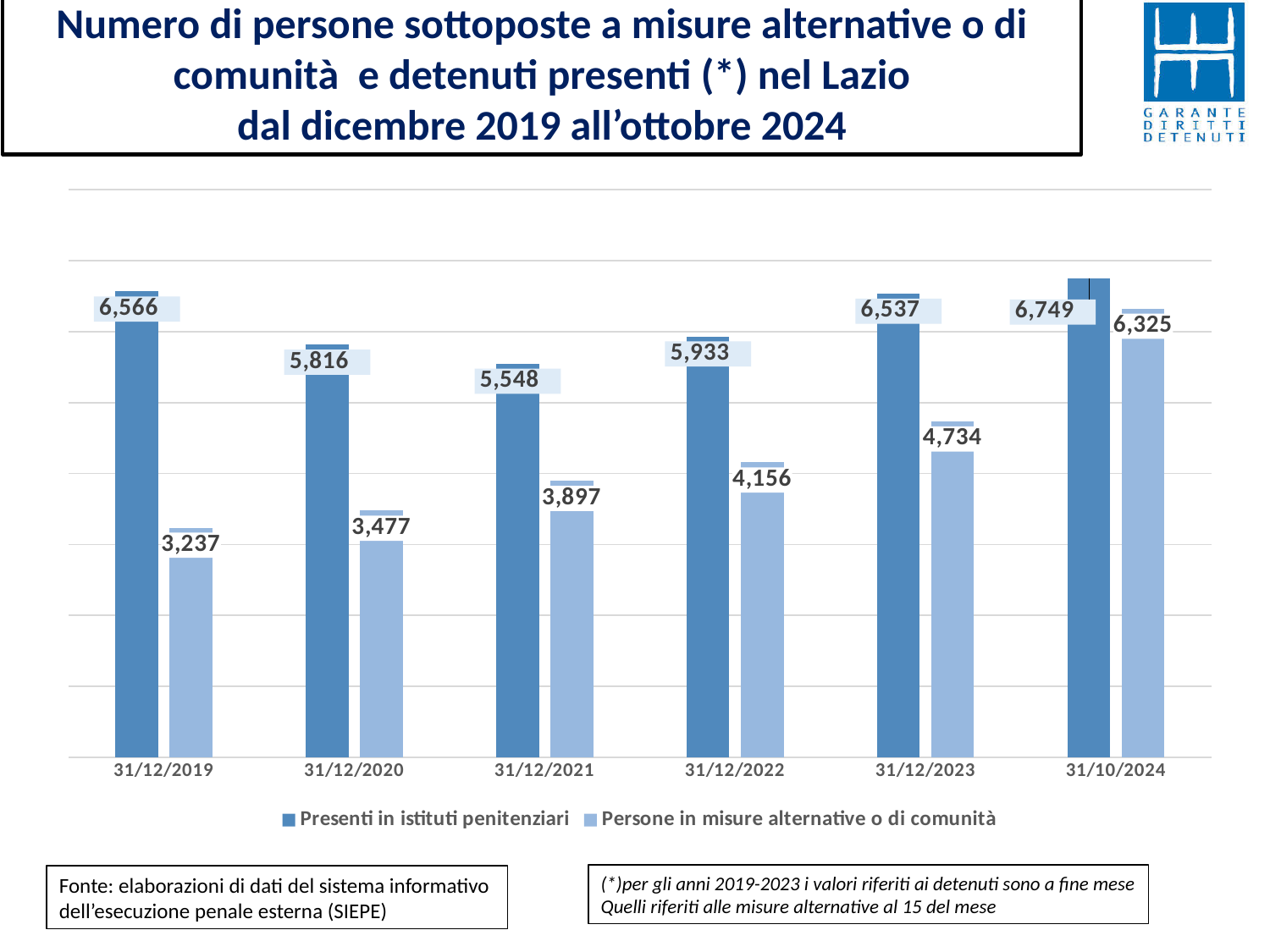
Do the values for 'Persone in misure alternative o di comunità' rise or fall from 31/12/2019 to 31/10/2024? rise What is the value for 'Presenti in istituti penitenziari' at 31/12/2019? 6,566 How many dates are shown on the x axis? 6 What is the value for 'Persone in misure alternative o di comunità' at 31/12/2022? 4,156 What is the difference between 'Presenti in istituti penitenziari' and 'Persone in misure alternative o di comunità' at 31/12/2023? 1,803 At which date is the value for 'Presenti in istituti penitenziari' highest? 31/10/2024 How many series does the legend list? 2 Which is larger at 31/12/2020: 'Presenti in istituti penitenziari' or 'Persone in misure alternative o di comunità'? Presenti in istituti penitenziari At which date is the value for 'Persone in misure alternative o di comunità' lowest? 31/12/2019 What kind of chart is shown on the slide? bar chart At which date is the value for 'Presenti in istituti penitenziari' lowest? 31/12/2021 What is the value for 'Persone in misure alternative o di comunità' at 31/10/2024? 6,325